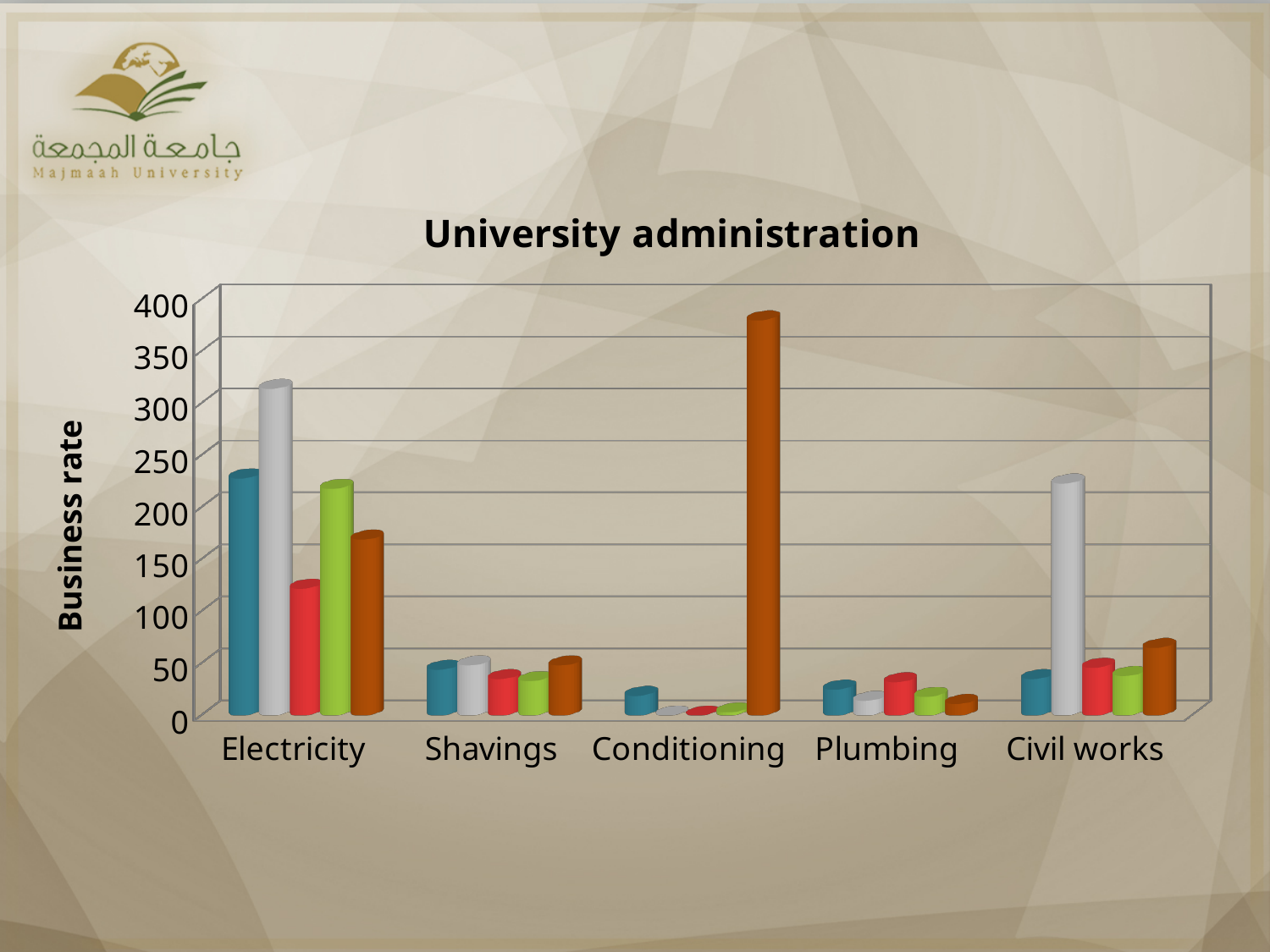
Is the grey bar for Civil works greater or less than 150? greater How many categories are shown along the x axis of the chart? 5 Is the teal bar for Electricity greater or less than 200? greater Which category has the tallest grey bar? Electricity What kind of chart is shown on the slide? Bar chart Is the orange bar for Conditioning greater or less than 350? greater What is the title of the chart? University administration What is the label on the vertical axis of the chart? Business rate Which category contains the tallest bar in the chart? Conditioning Which is larger: the grey bar for Electricity or the grey bar for Civil works? Electricity Which is larger: the orange bar for Conditioning or the orange bar for Electricity? Conditioning